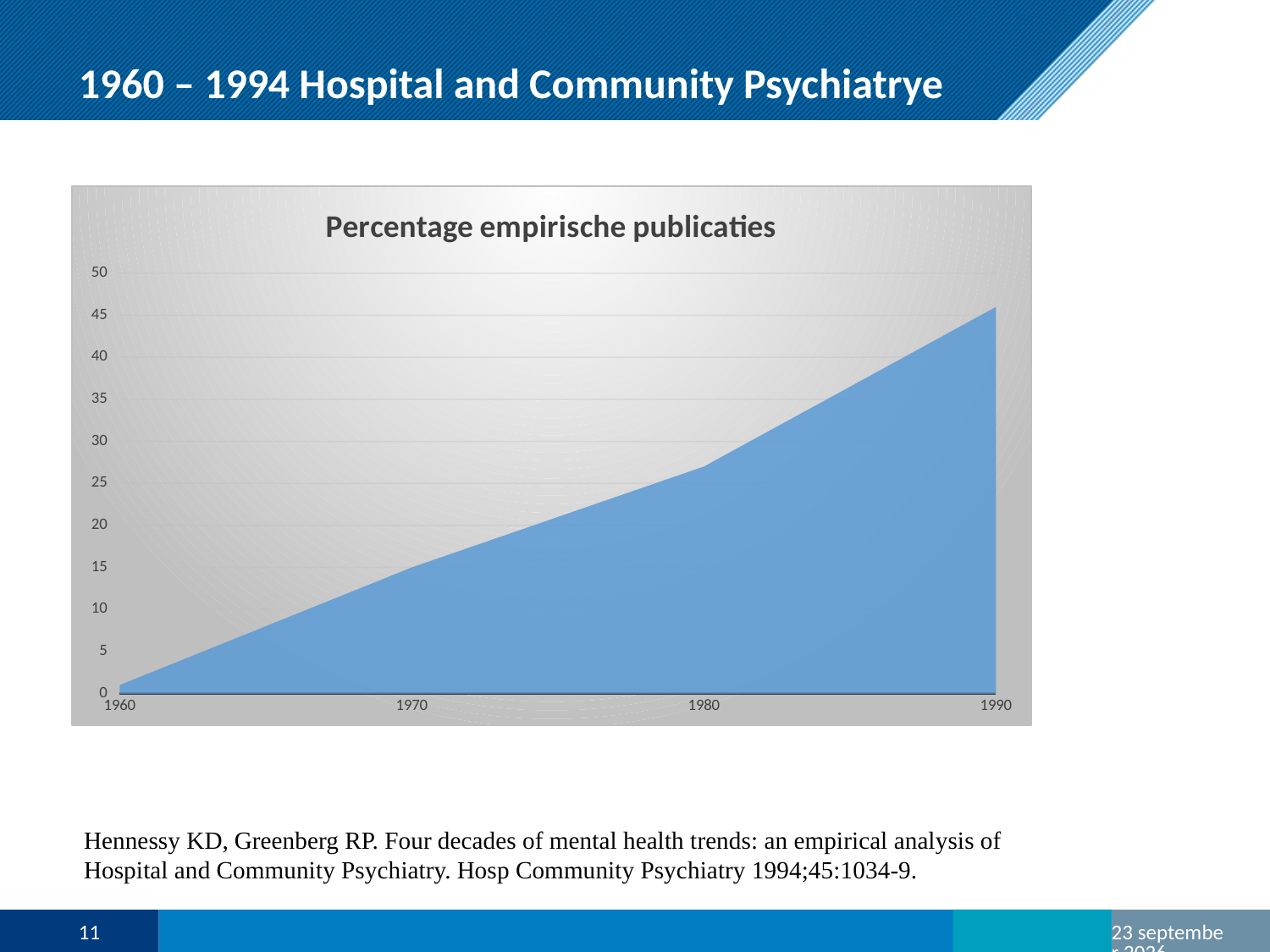
Is the value for 1980 greater or less than 20? greater What is the title of the chart? Percentage empirische publicaties Is the value for 1960 greater or less than 5? less Which is larger, the value for 1980 or the value for 1970? 1980 Which year has the lowest value? 1960 Which year has the highest value? 1990 What is the highest value shown on the y axis of the chart? 50 Do the values rise or fall from 1960 to 1990? rise What kind of chart is shown on the slide? area chart How many years are labelled on the x axis of the chart? 4 Is the value for 1970 greater or less than 20? less